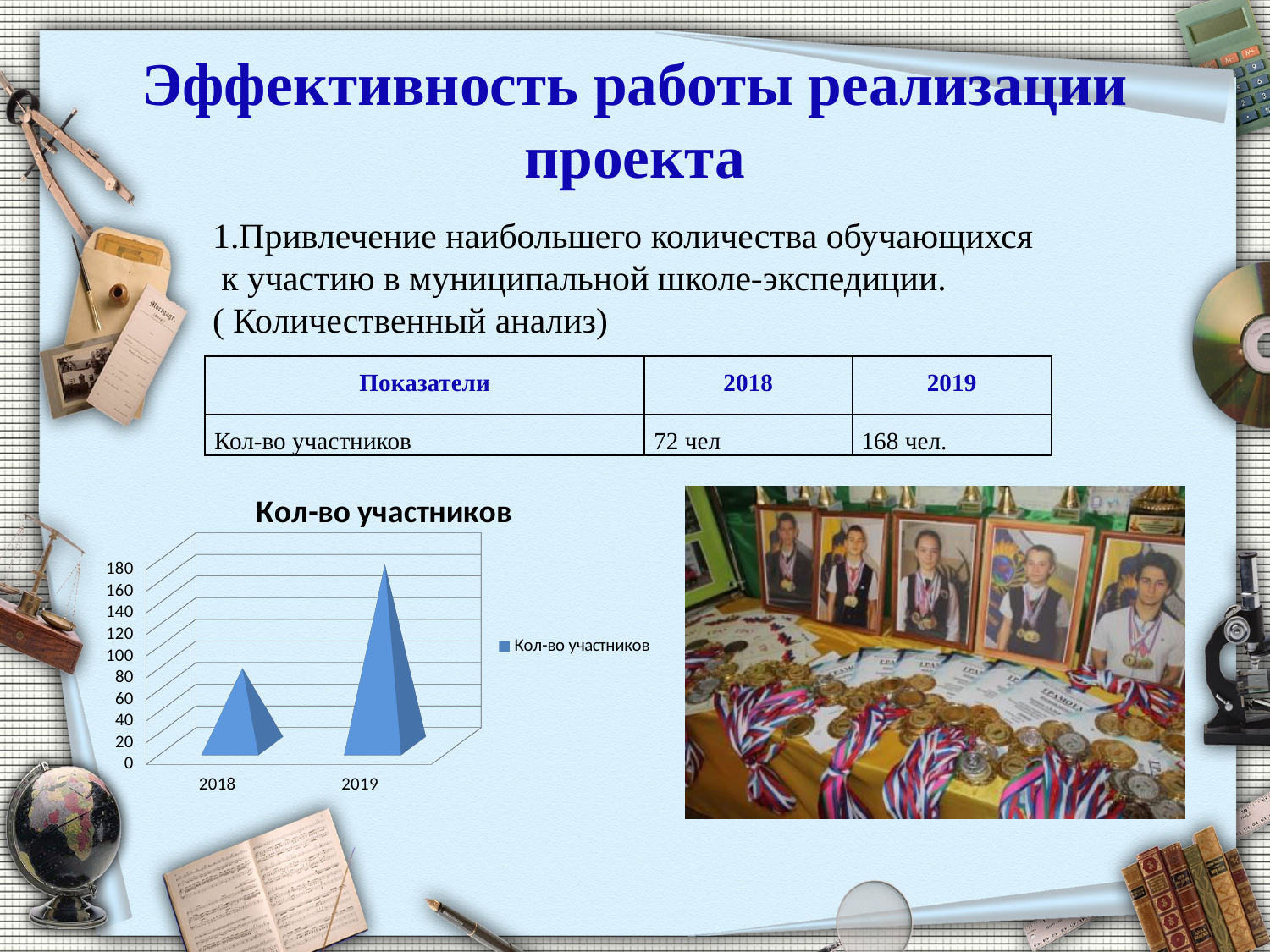
Which year has the higher value in the chart? 2019 Is the value for 2019 in the chart greater or less than 160? greater What is the highest tick value shown on the chart's vertical axis? 180 Is the value for 2018 in the chart greater or less than 100? less What is the title of the chart on the slide? Кол-во участников Is the value for 2018 in the chart greater or less than 60? greater Which year has the lower value in the chart? 2018 How many series does the chart's legend list? 1 What kind of chart is shown on the slide? bar chart What series name appears in the chart's legend? Кол-во участников Do the values in the chart rise or fall from 2018 to 2019? rise How many categories are shown on the x axis of the chart? 2